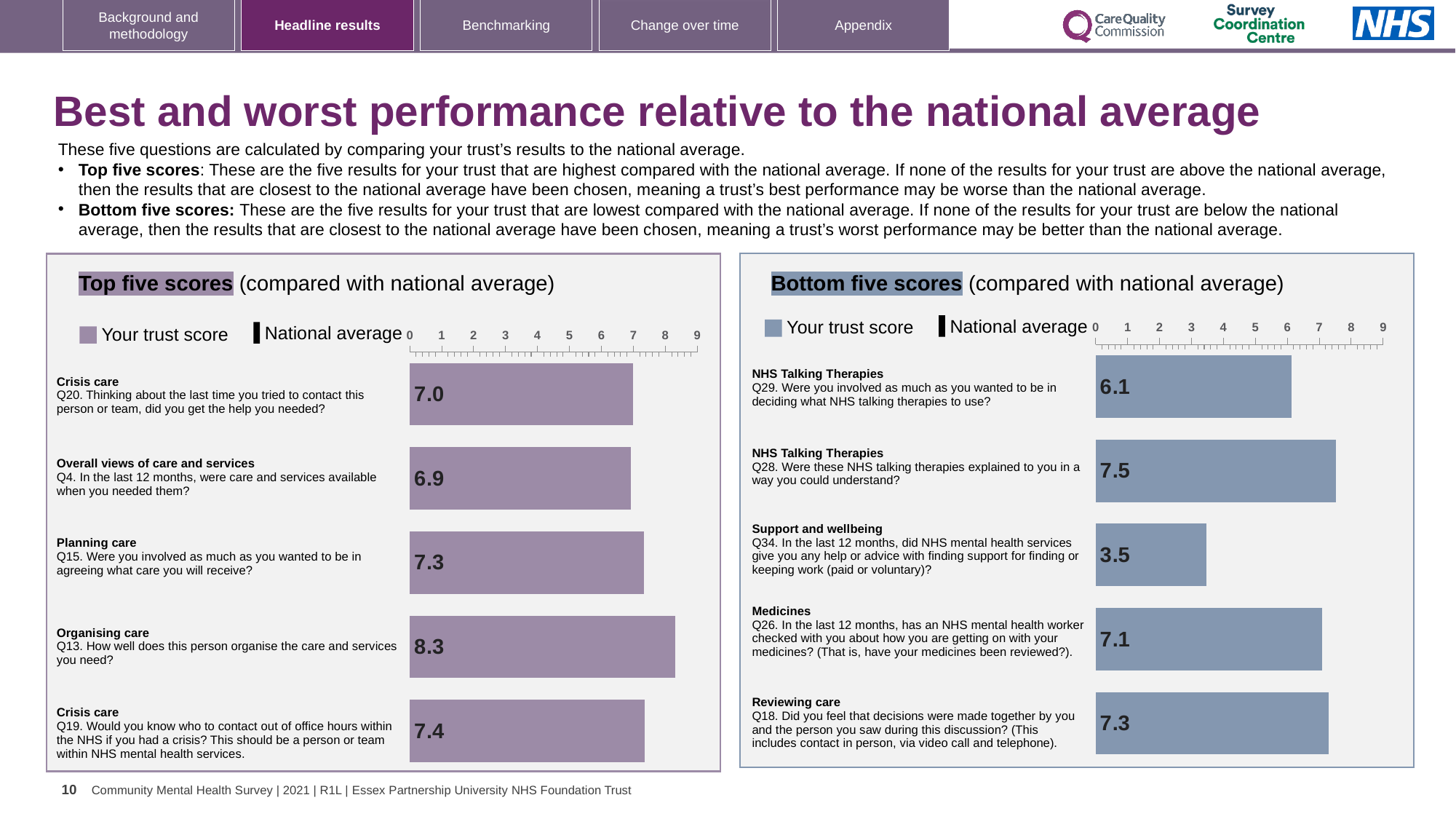
What type of chart is the Top five scores chart? Bar chart In the Bottom five scores chart, which has the larger trust score, Q29 or Q26? Q26 In the Top five scores chart, what is the trust score for Q4 (Overall views of care and services)? 6.9 In the Top five scores chart, which question has the highest trust score? Q13 How many questions are shown in the Bottom five scores chart? 5 In the Bottom five scores chart, what is the trust score for Q28 (NHS Talking Therapies)? 7.5 In the Bottom five scores chart, which question has the lowest trust score? Q34 In the Bottom five scores chart, which question has the highest trust score? Q28 In the Top five scores chart, what is the difference between the trust scores for Q13 and Q20? 1.3 In the Top five scores chart, which question has the lowest trust score? Q4 In the Top five scores chart, what is the trust score for Q13 (Organising care)? 8.3 In the Bottom five scores chart, what is the trust score for Q34 (Support and wellbeing)? 3.5